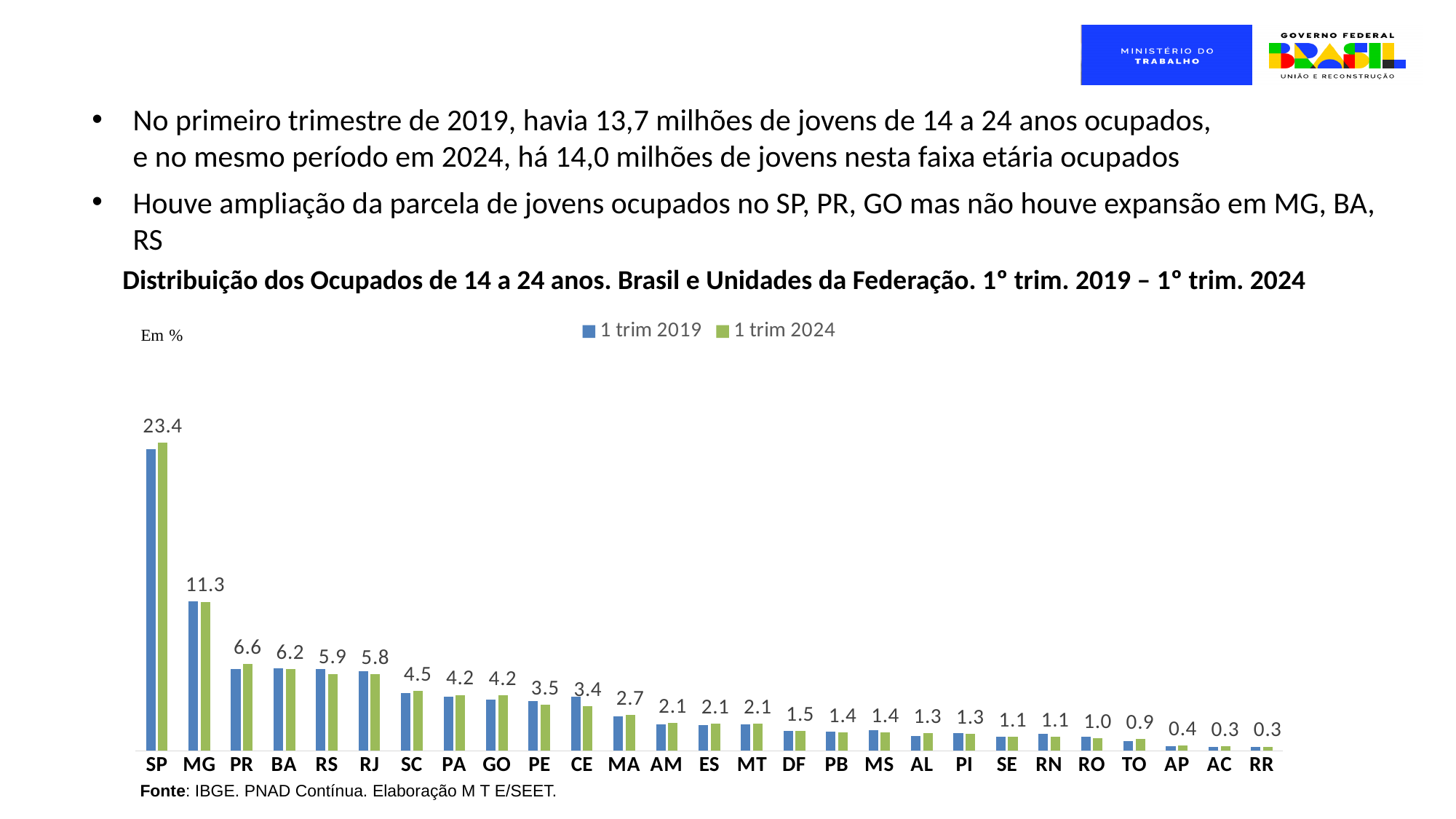
What kind of chart is shown on the slide? bar chart For SP, which bar is taller: 1 trim 2019 or 1 trim 2024? 1 trim 2024 Which state has the highest share of occupied youths aged 14 to 24 in the chart? SP What is the data label shown for MG in the chart? 11.3 How many series does the chart legend list? 2 What is the data label shown for PR in the chart? 6.6 How many states (categories) are shown on the x axis of the chart? 27 What are the two series named in the chart legend? 1 trim 2019 and 1 trim 2024 For RS, which bar is taller: 1 trim 2019 or 1 trim 2024? 1 trim 2019 What is the data label shown for CE in the chart? 3.4 What is the data label shown for SP in the chart? 23.4 What is the difference between the data labels shown for SP and MG? 12.1